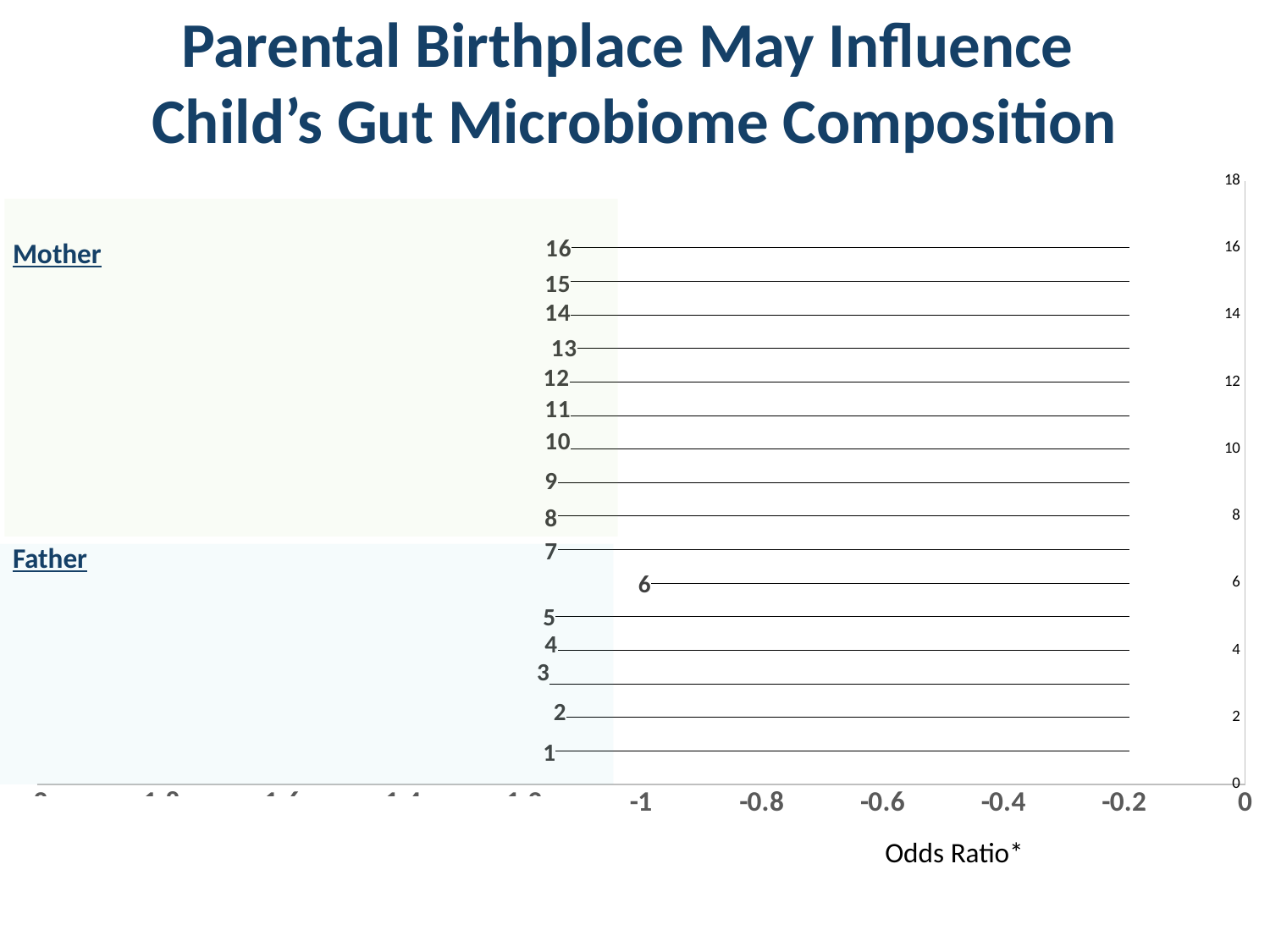
How many numbered horizontal lines are plotted on the chart? 16 What is the rightmost tick value on the horizontal axis? 0 How many numbered lines fall within the Father section of the chart? 7 How many numbered lines fall within the Mother section of the chart? 9 What is the highest value shown on the right-hand vertical axis? 18 Which group label appears in the upper section of the chart, Mother or Father? Mother What is the title of the chart's horizontal axis? Odds Ratio*